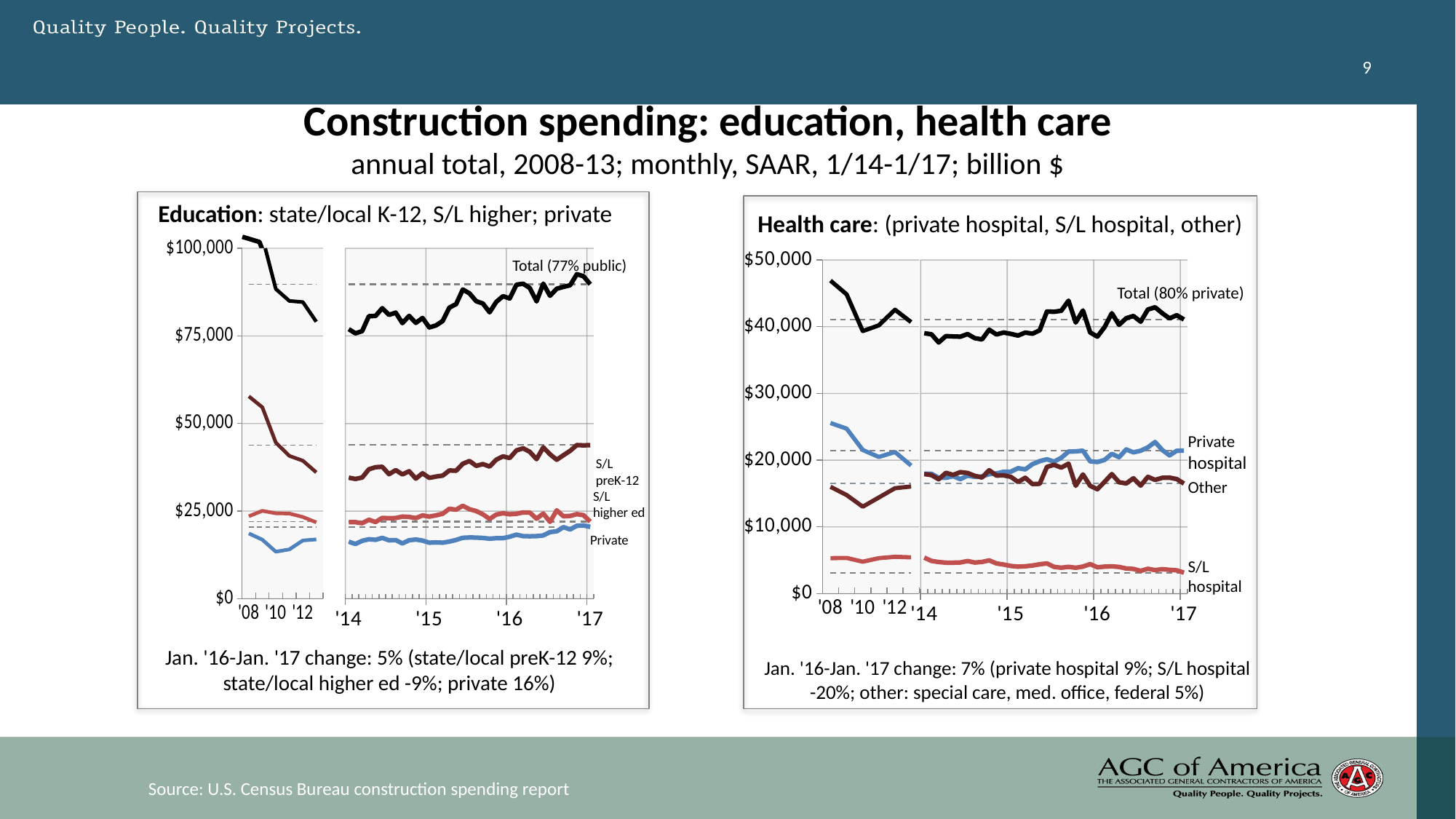
On the Health care chart, which series is the lowest throughout the period shown? S/L hospital On the Health care chart, is the S/L hospital value in 2017 greater or less than $10,000? less On the Education chart, is the Total value in 2017 greater or less than $75,000? greater On the Education chart, does the Total line rise or fall from 2008 to 2013? fall On the Education chart, which is larger in 2017: S/L preK-12 or Private? S/L preK-12 What kind of chart is the Education chart? line chart On the Health care chart, which is larger in 2017: Private hospital or S/L hospital? Private hospital On the Health care chart, does the Private hospital line rise or fall from 2014 to 2017? rise According to the label on the Education chart, what share of the Total is public? 77% On the Health care chart, is the Total value in 2008 greater or less than $40,000? greater How many lines are plotted on the Health care chart? 4